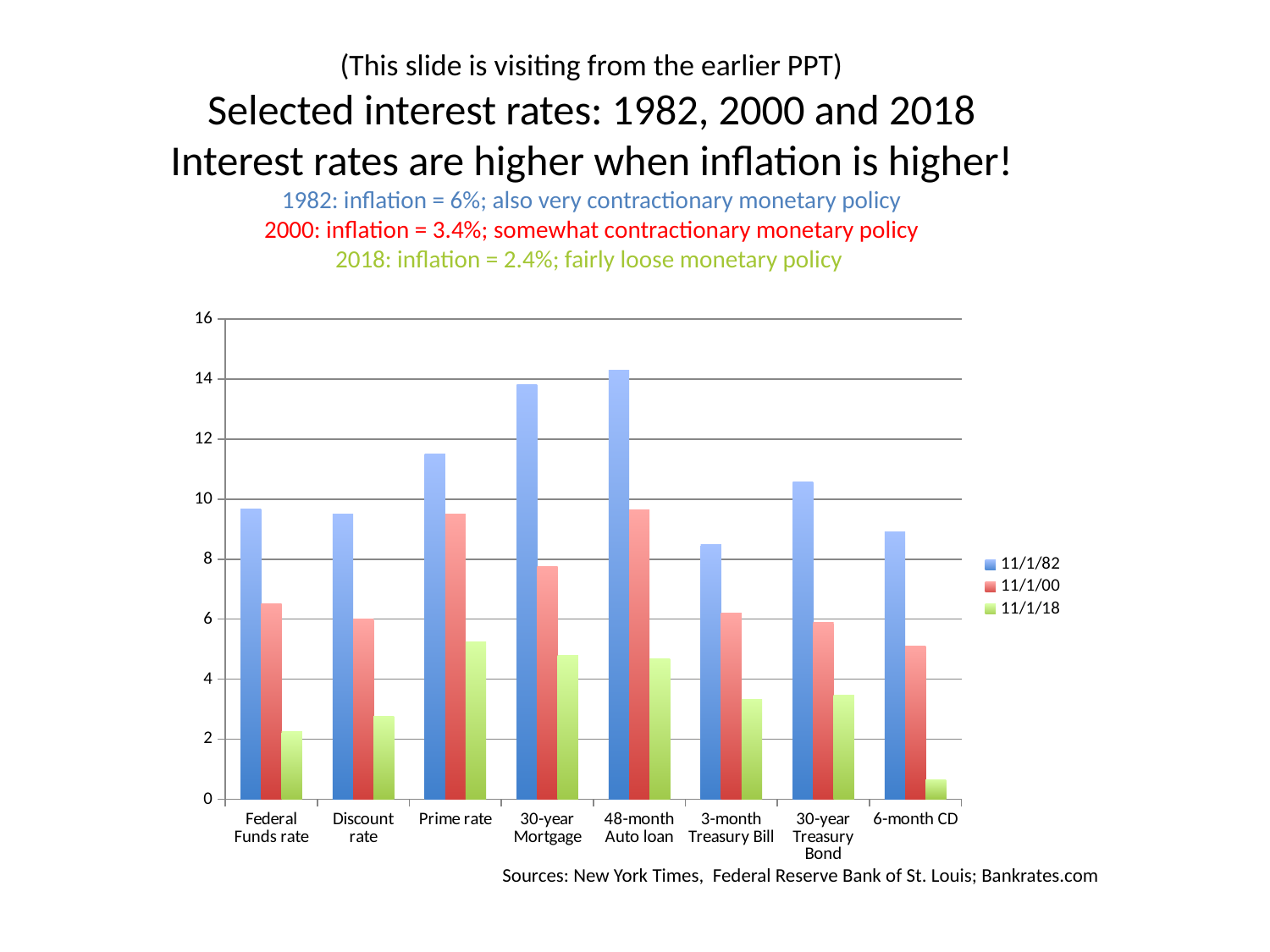
Is the 11/1/18 value for Federal Funds rate greater or less than 4? less Which category has the highest value for the 11/1/18 series? Prime rate Is the 11/1/82 value for Prime rate greater or less than 10? greater Which series is shown in green in the legend? 11/1/18 Is the 11/1/00 value for 30-year Mortgage greater or less than 6? greater Which category has the highest value for the 11/1/82 series? 48-month Auto loan Which category has the lowest value for the 11/1/18 series? 6-month CD What kind of chart is shown on the slide? Bar chart For Federal Funds rate, which series has the larger value: 11/1/82 or 11/1/00? 11/1/82 How many interest-rate categories are shown along the x axis? 8 How many series does the legend list? 3